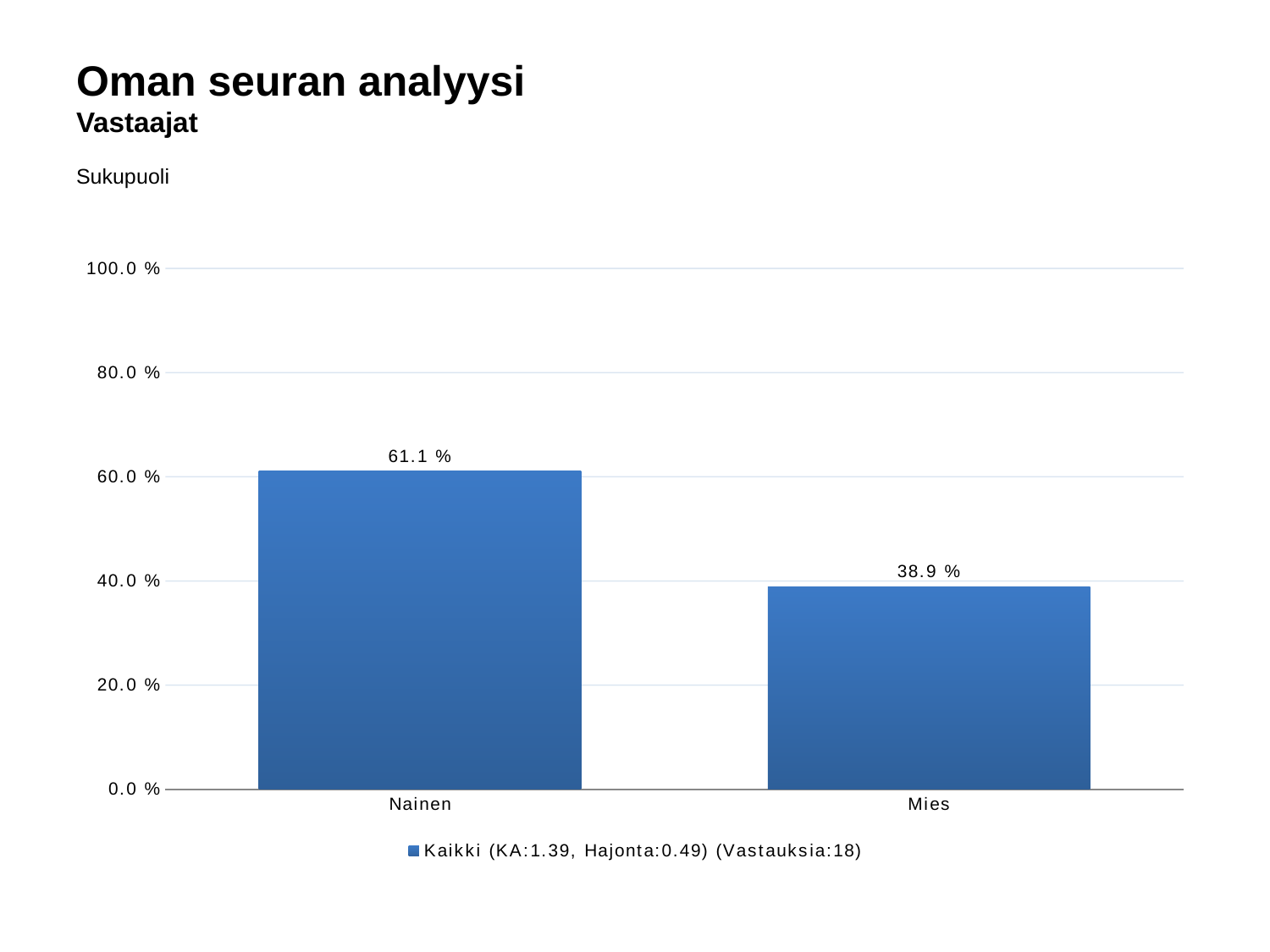
How many categories are shown on the x axis? 2 Is the value for Mies greater or less than 40.0 %? less What is the difference between the values for Nainen and Mies? 22.2 % Which category has the lowest value? Mies Which category has the highest value? Nainen How many series does the legend list? 1 Which is larger, the value for Nainen or the value for Mies? Nainen What is the value for Nainen? 61.1 % Is the value for Nainen greater or less than 60.0 %? greater What kind of chart is shown? bar chart What is the legend entry for the series? Kaikki (KA:1.39, Hajonta:0.49) (Vastauksia:18) What is the value for Mies? 38.9 %